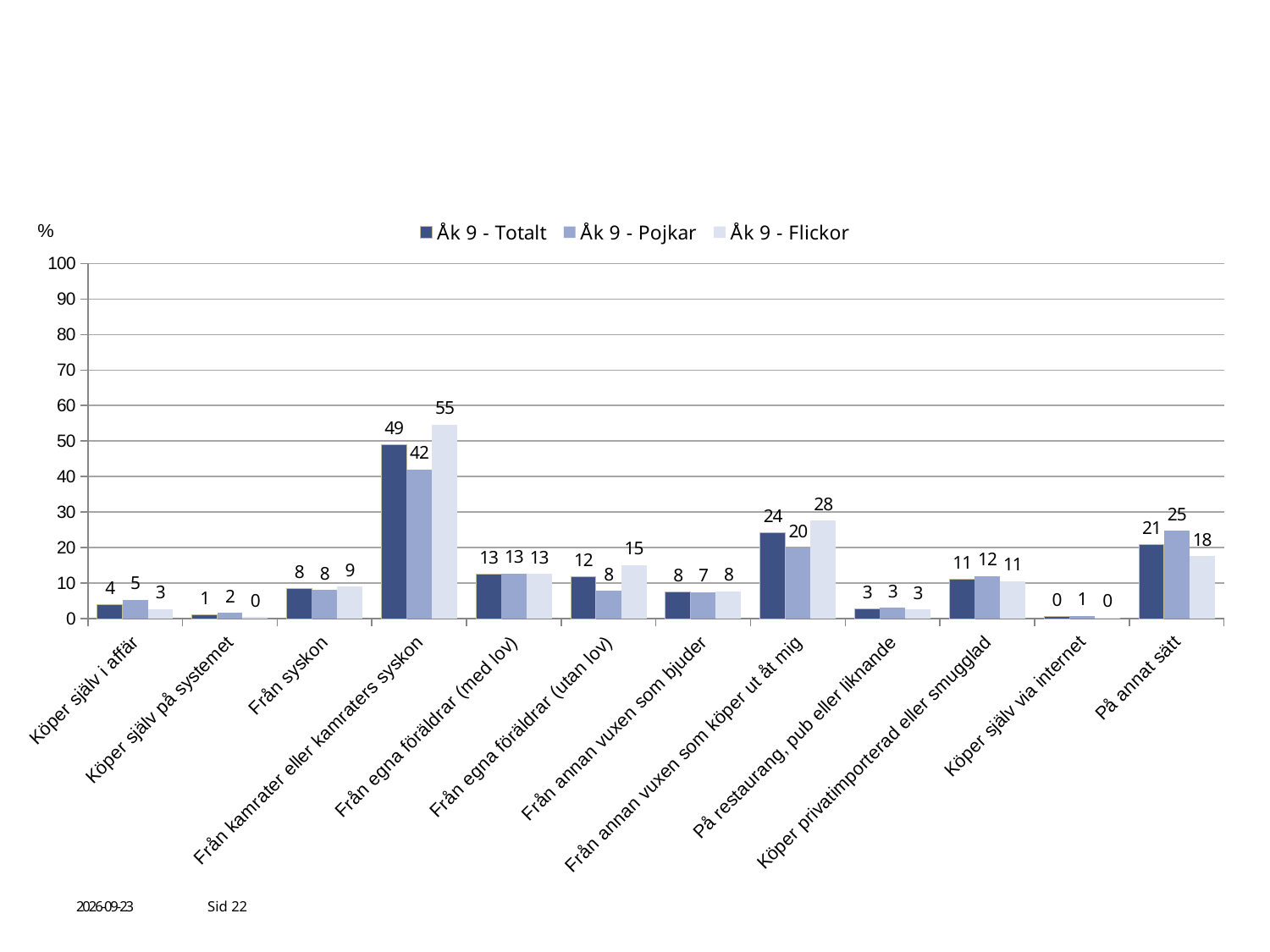
How many categories are shown on the x axis? 12 What unit is shown on the y axis label? % Which category has the highest value for Åk 9 - Totalt? Från kamrater eller kamraters syskon Is the value for Åk 9 - Totalt in 'Från kamrater eller kamraters syskon' greater or less than 40? greater Which is larger for 'Från egna föräldrar (utan lov)': Åk 9 - Pojkar or Åk 9 - Flickor? Åk 9 - Flickor What is the value for Åk 9 - Totalt in the category 'Från annan vuxen som köper ut åt mig'? 24 Which category has the lowest value for Åk 9 - Pojkar? Köper själv via internet How many series does the legend list? 3 What is the value for Åk 9 - Flickor in the category 'Från kamrater eller kamraters syskon'? 55 What is the value for Åk 9 - Pojkar in the category 'På annat sätt'? 25 What is the difference between the Åk 9 - Flickor and Åk 9 - Pojkar values for 'Från kamrater eller kamraters syskon'? 13 What kind of chart is shown on the slide? Bar chart